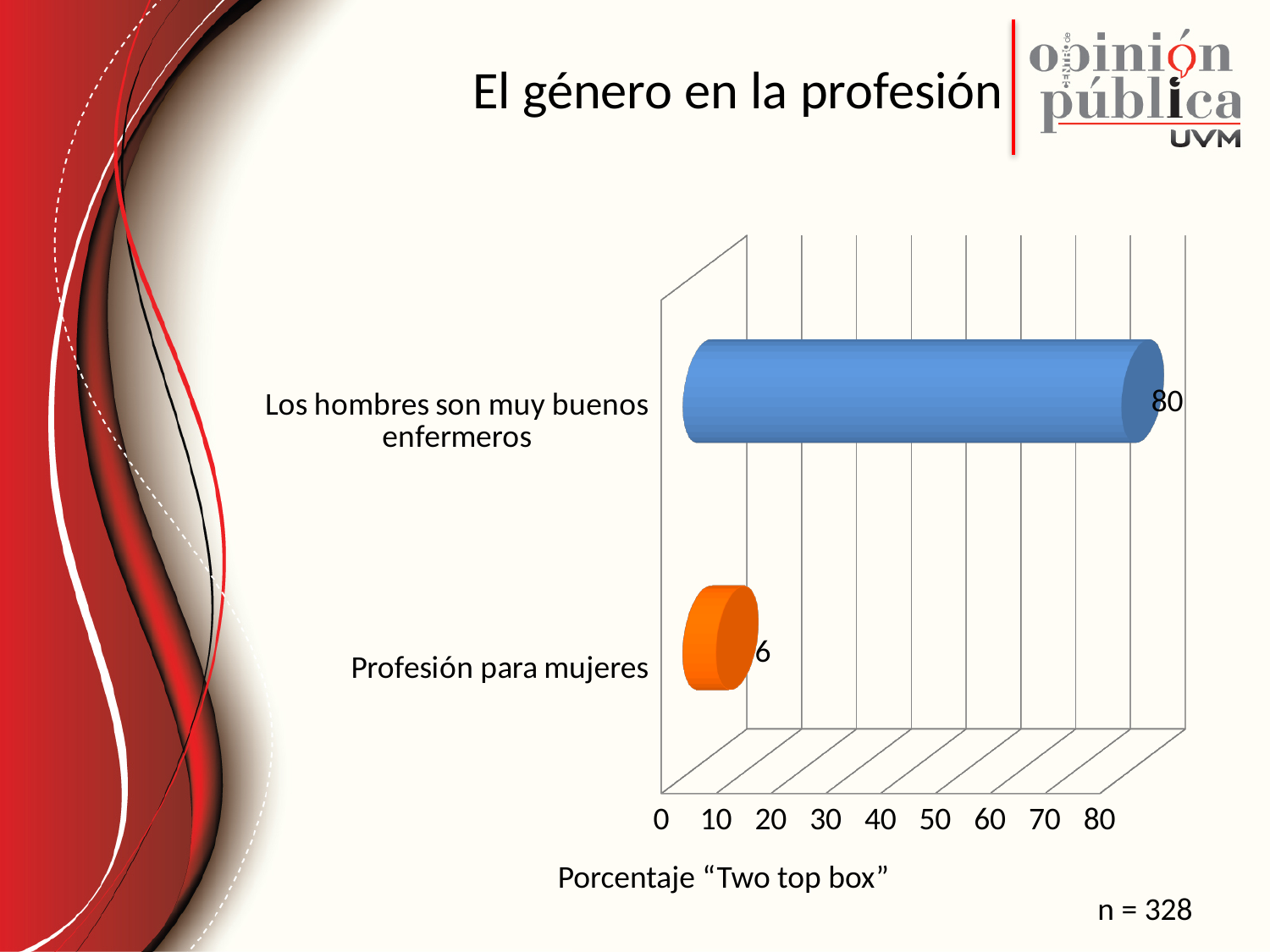
What is the difference between the values for "Los hombres son muy buenos enfermeros" and "Profesión para mujeres"? 74 Which category has the lowest value? Profesión para mujeres Is the value for "Profesión para mujeres" greater or less than 10? less Which is larger: the value for "Los hombres son muy buenos enfermeros" or for "Profesión para mujeres"? Los hombres son muy buenos enfermeros What sample size (n) is shown on the slide? n = 328 What is the value for "Los hombres son muy buenos enfermeros"? 80 Which category has the highest value? Los hombres son muy buenos enfermeros Is the value for "Los hombres son muy buenos enfermeros" greater or less than 70? greater What kind of chart is shown on the slide? bar chart What is the value for "Profesión para mujeres"? 6 How many categories are shown in the chart? 2 What is the label of the horizontal axis of the chart? Porcentaje "Two top box"